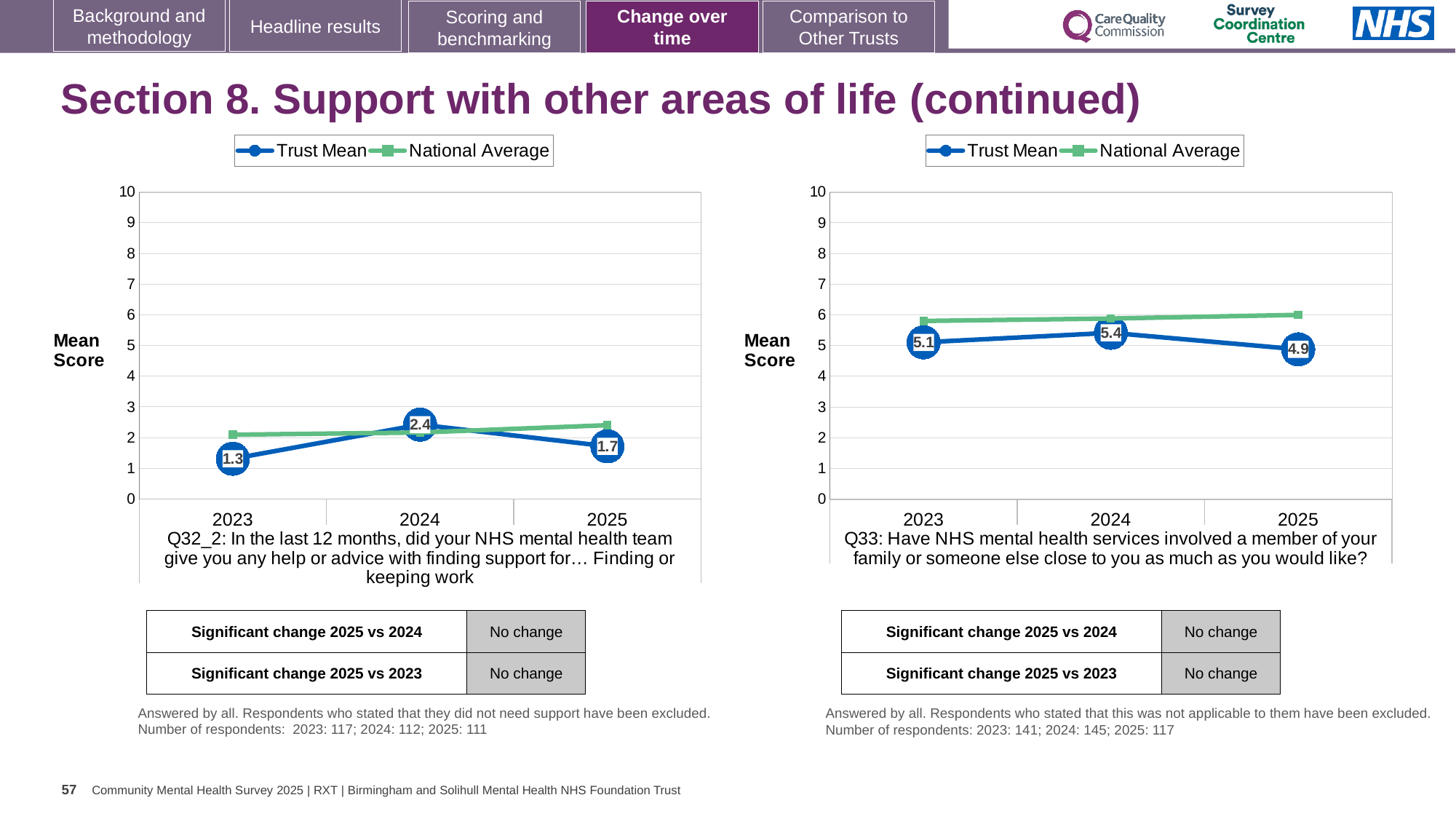
In the left chart (Q32_2), what is the difference between the Trust Mean for 2024 and 2023? 1.1 In the right chart (Q33), which year has the highest Trust Mean? 2024 In the right chart (Q33), is the National Average for 2025 greater or less than 5? greater In the left chart (Q32_2), what is the Trust Mean for 2023? 1.3 In the right chart (Q33), is the Trust Mean for 2023 or 2025 larger? 2023 In the right chart (Q33), what is the difference between the Trust Mean for 2024 and 2025? 0.5 In the left chart (Q32_2), what is the Trust Mean for 2024? 2.4 In the right chart (Q33), what is the Trust Mean for 2025? 4.9 What kind of chart is the right chart (Q33)? Line chart In the left chart (Q32_2), which year has the lowest Trust Mean? 2023 In the left chart (Q32_2), is the National Average for 2023 greater or less than 3? less How many series does the legend of the left chart list? 2